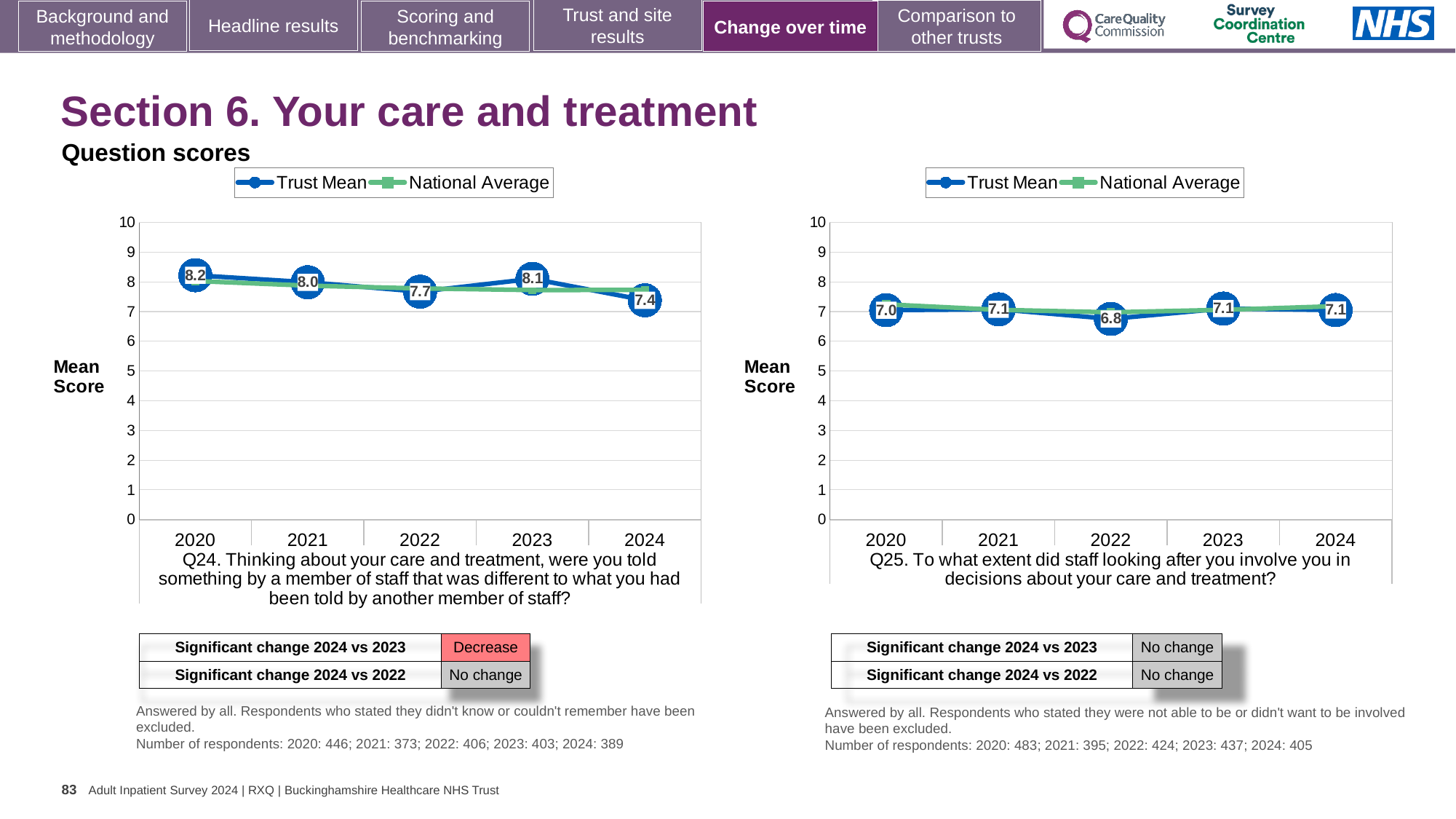
In the Q24 chart on the left, what is the Trust Mean score for 2020? 8.2 In the Q24 chart on the left, what is the Trust Mean score for 2024? 7.4 In the Q25 chart on the right, which year has the lowest Trust Mean score? 2022 How many series does the legend of the Q25 chart on the right list? 2 What kind of chart is the Q24 chart on the left? Line chart In the Q24 chart on the left, which year has the lowest Trust Mean score? 2024 In the Q24 chart on the left, which year has the highest Trust Mean score? 2020 In the Q25 chart on the right, what is the Trust Mean score for 2022? 6.8 How many years are plotted on the x axis of the Q24 chart on the left? 5 In the Q25 chart on the right, what is the difference between the Trust Mean scores for 2021 and 2022? 0.3 In the Q25 chart on the right, is the Trust Mean score for 2020 greater or less than the Trust Mean score for 2022? greater In the Q24 chart on the left, what is the difference between the Trust Mean scores for 2023 and 2024? 0.7